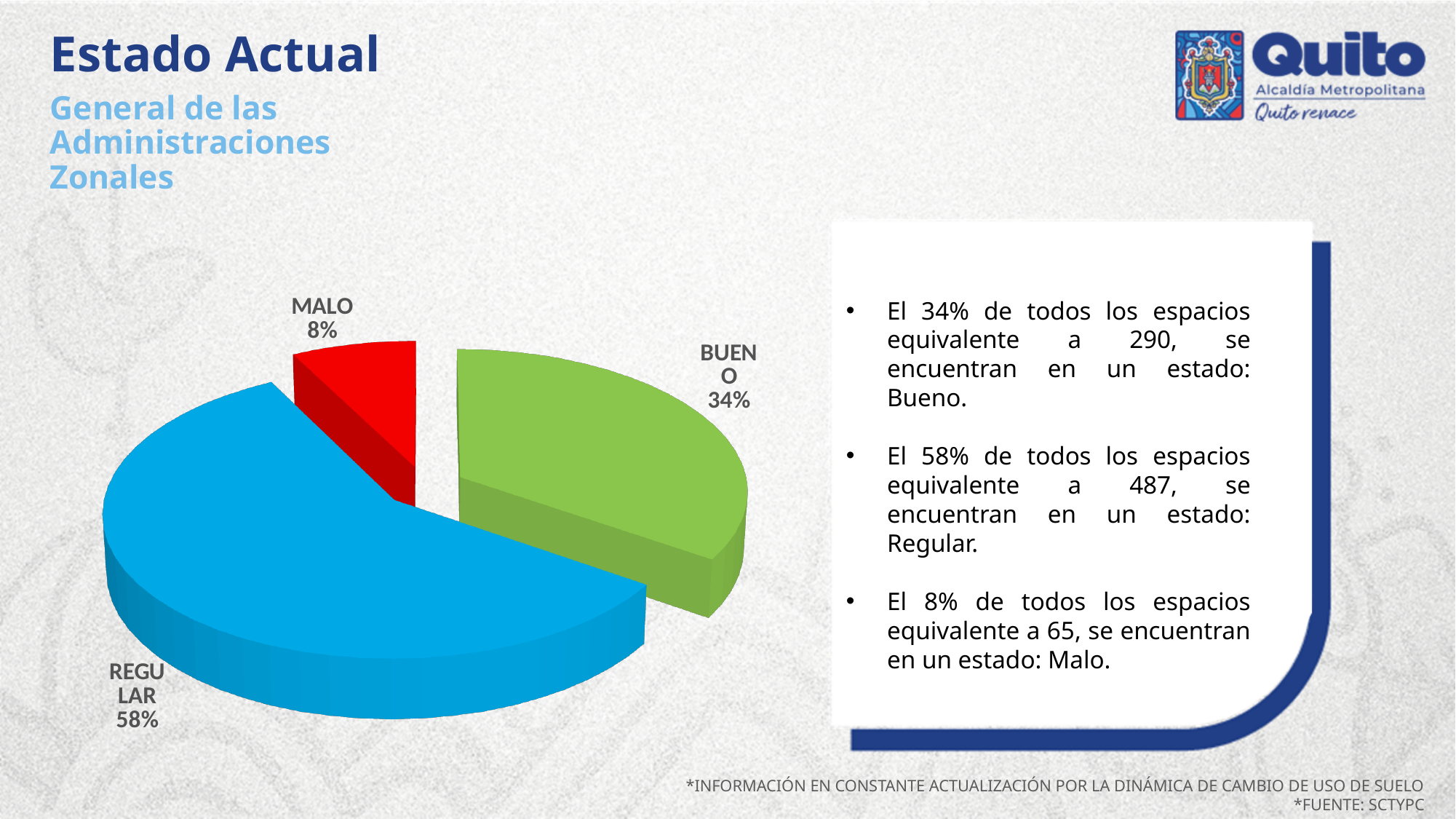
Which slice is larger, BUENO or MALO? BUENO Which category has the smallest slice of the pie? MALO What share of the pie does the REGULAR slice represent? 58% How many slices does the pie chart have? 3 What colour is the REGULAR slice of the pie? Blue What is the difference in percentage points between the BUENO and MALO slices? 26 What kind of chart is shown on the slide? Pie chart What share of the pie does the MALO slice represent? 8% Which category has the largest slice of the pie? REGULAR What share of the pie does the BUENO slice represent? 34% What is the difference in percentage points between the REGULAR and BUENO slices? 24 What colour is the MALO slice of the pie? Red